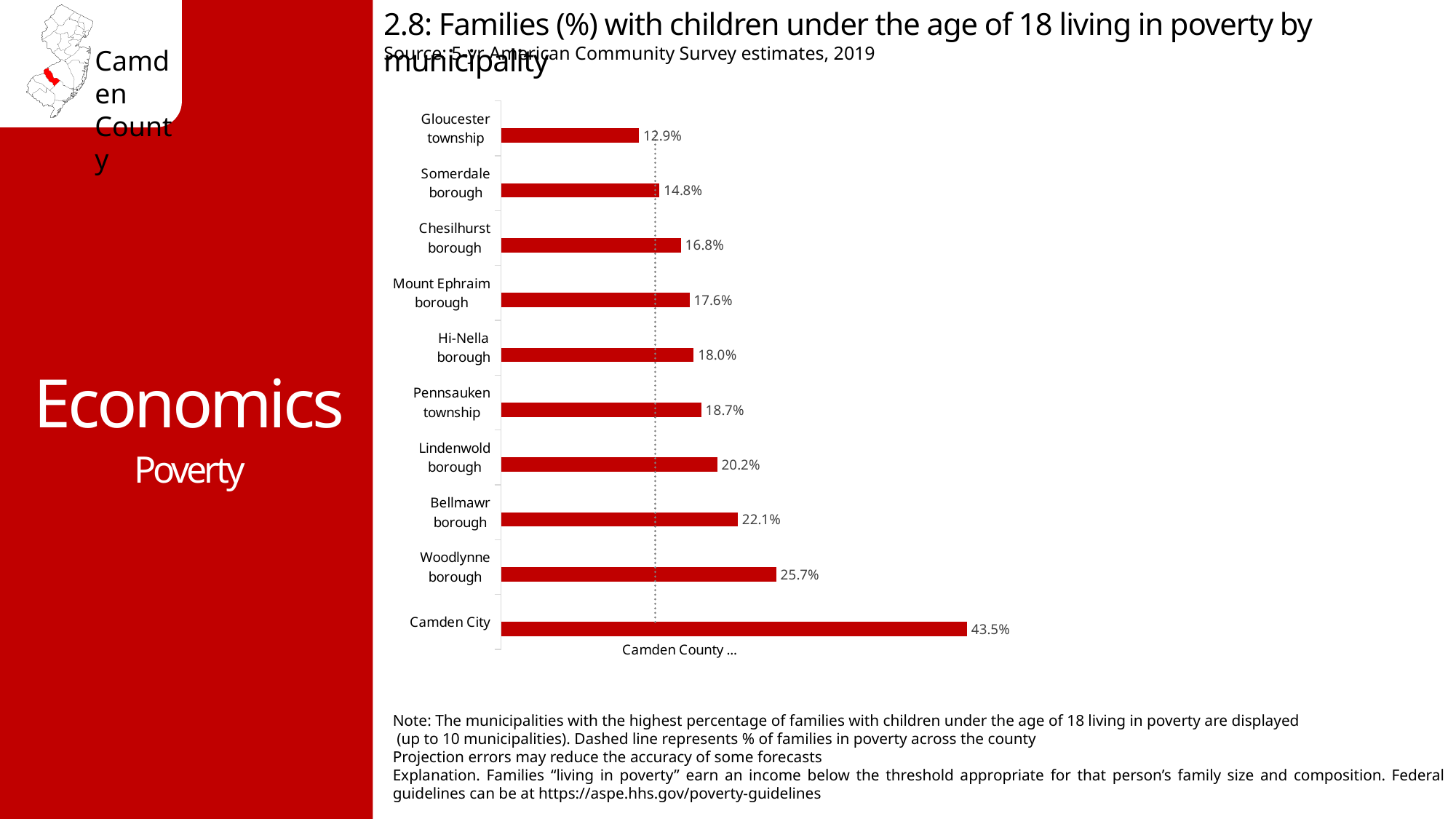
What is the value for Lindenwold borough? 20.2% How many municipalities are shown on the chart? 10 Which is larger, the value for Pennsauken township or the value for Hi-Nella borough? Pennsauken township What is the value for Gloucester township? 12.9% What kind of chart is shown on the slide? Bar chart What is the difference between the values for Camden City and Woodlynne borough? 17.8% Which municipality has the lowest percentage shown on the chart? Gloucester township What is the value for Camden City? 43.5% What is the difference between the values for Bellmawr borough and Somerdale borough? 7.3% Which municipality has the highest percentage of families with children under 18 living in poverty? Camden City What is the value for Woodlynne borough? 25.7% What does the dashed vertical line on the chart represent? Camden County % of families in poverty